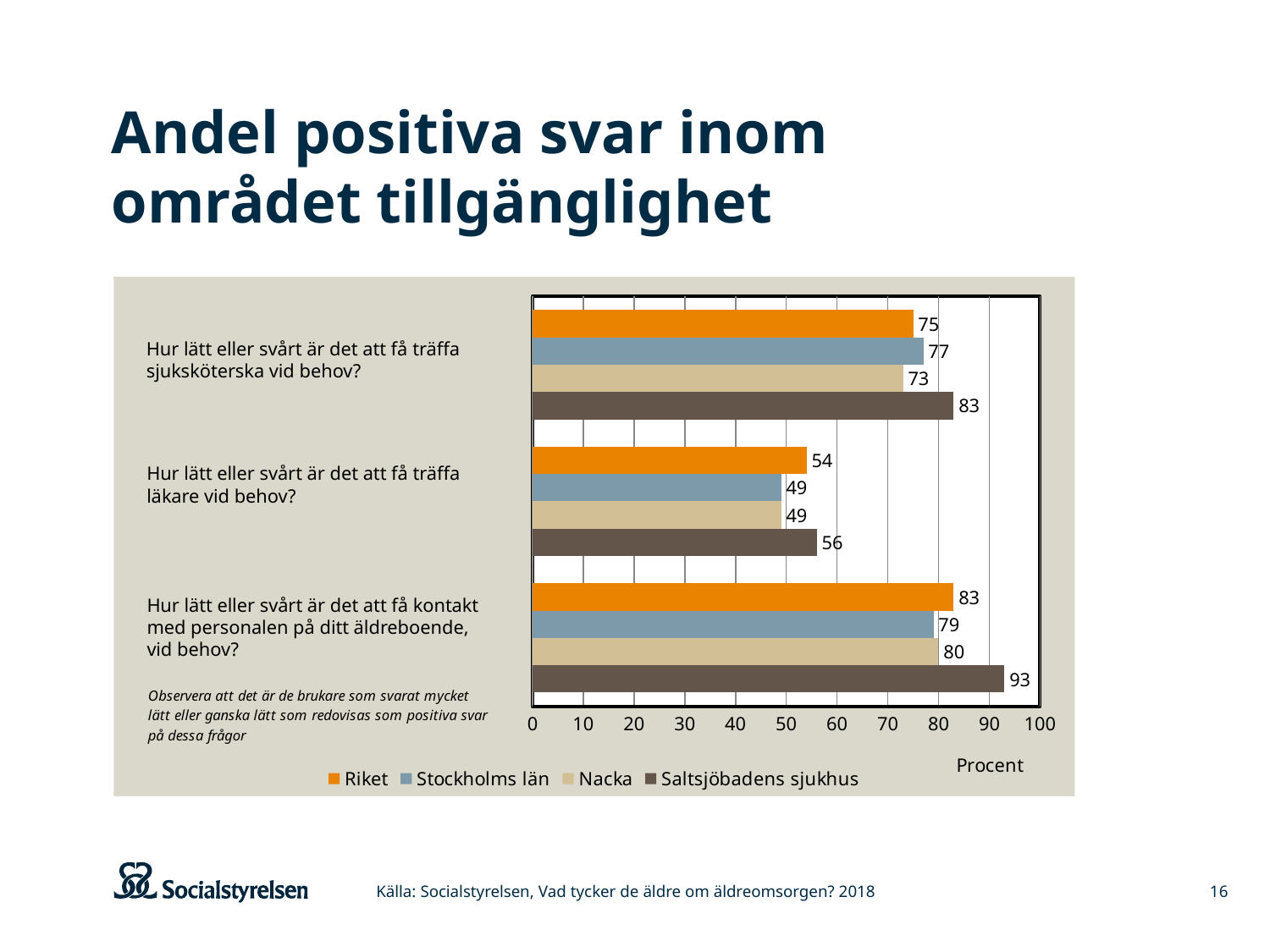
Which is larger on the question "Hur lätt eller svårt är det att få träffa läkare vid behov?": Riket or Saltsjöbadens sjukhus? Saltsjöbadens sjukhus What is the value for Stockholms län on the question "Hur lätt eller svårt är det att få kontakt med personalen på ditt äldreboende, vid behov?"? 79 What is the difference between Saltsjöbadens sjukhus and Riket on the question "Hur lätt eller svårt är det att få kontakt med personalen på ditt äldreboende, vid behov?"? 10 What is the label of the horizontal axis? Procent Which series has the lowest value on the question "Hur lätt eller svårt är det att få kontakt med personalen på ditt äldreboende, vid behov?"? Stockholms län Which series has the highest value on the question "Hur lätt eller svårt är det att få träffa sjuksköterska vid behov?"? Saltsjöbadens sjukhus What is the value for Riket on the question "Hur lätt eller svårt är det att få träffa läkare vid behov?"? 54 How many questions (categories) are shown on the chart? 3 What is the value for Nacka on the question "Hur lätt eller svårt är det att få träffa sjuksköterska vid behov?"? 73 How many series does the legend list? 4 What kind of chart is shown on the slide? Bar chart What is the value for Saltsjöbadens sjukhus on the question "Hur lätt eller svårt är det att få kontakt med personalen på ditt äldreboende, vid behov?"? 93